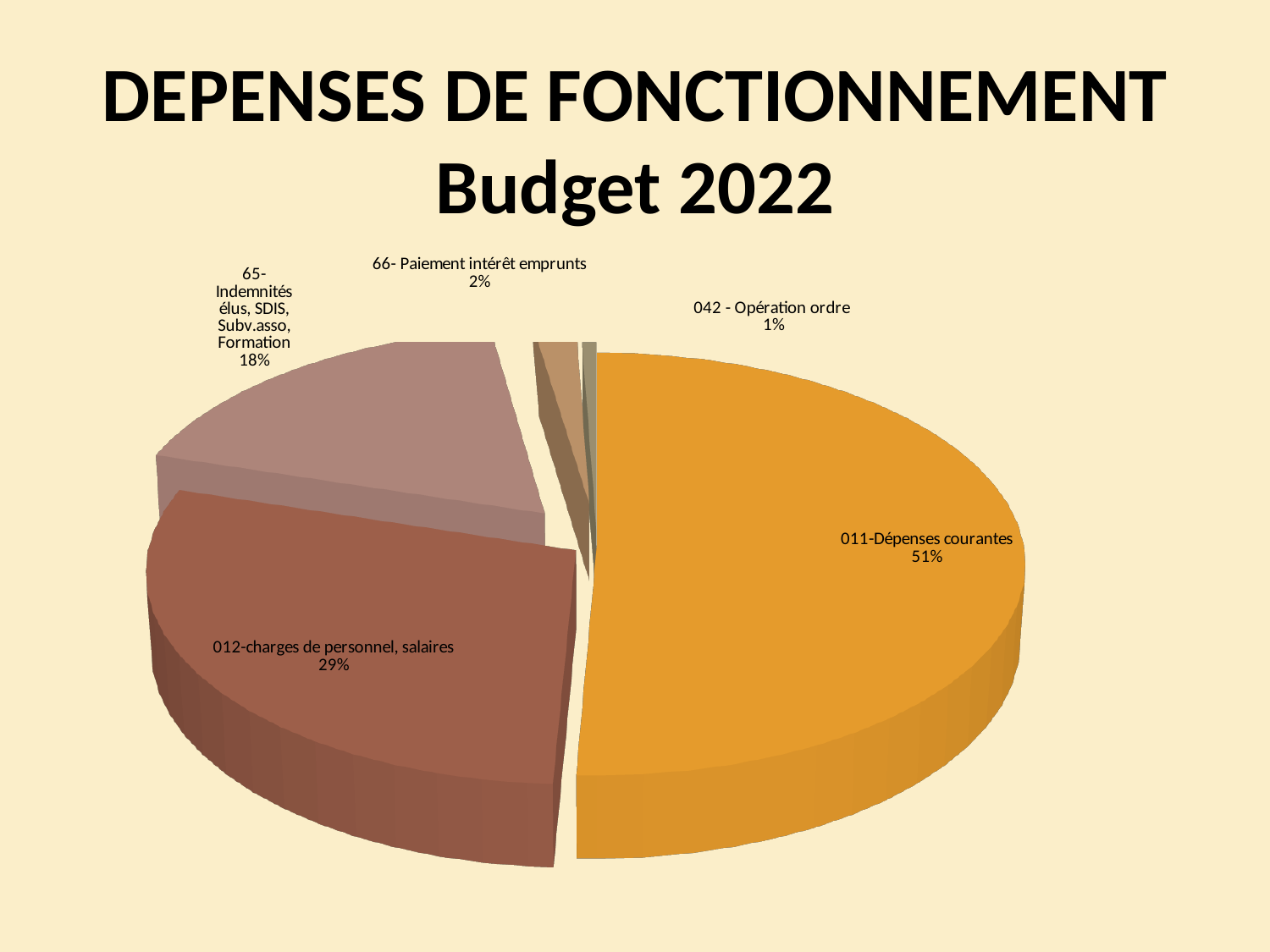
Which category has the largest slice of the pie? 011-Dépenses courantes What share of the pie does 65- Indemnités élus, SDIS, Subv.asso, Formation represent? 18% What kind of chart is shown on the slide? Pie chart What share of the pie does 66- Paiement intérêt emprunts represent? 2% What is the title of the slide? DEPENSES DE FONCTIONNEMENT Budget 2022 What is the difference in percentage points between 011-Dépenses courantes and 012-charges de personnel, salaires? 22 Which category has the smallest slice of the pie? 042 - Opération ordre How many categories are shown in the pie chart? 5 What share of the pie does 042 - Opération ordre represent? 1% Which is larger: the share for 65- Indemnités élus, SDIS, Subv.asso, Formation or the share for 012-charges de personnel, salaires? 012-charges de personnel, salaires